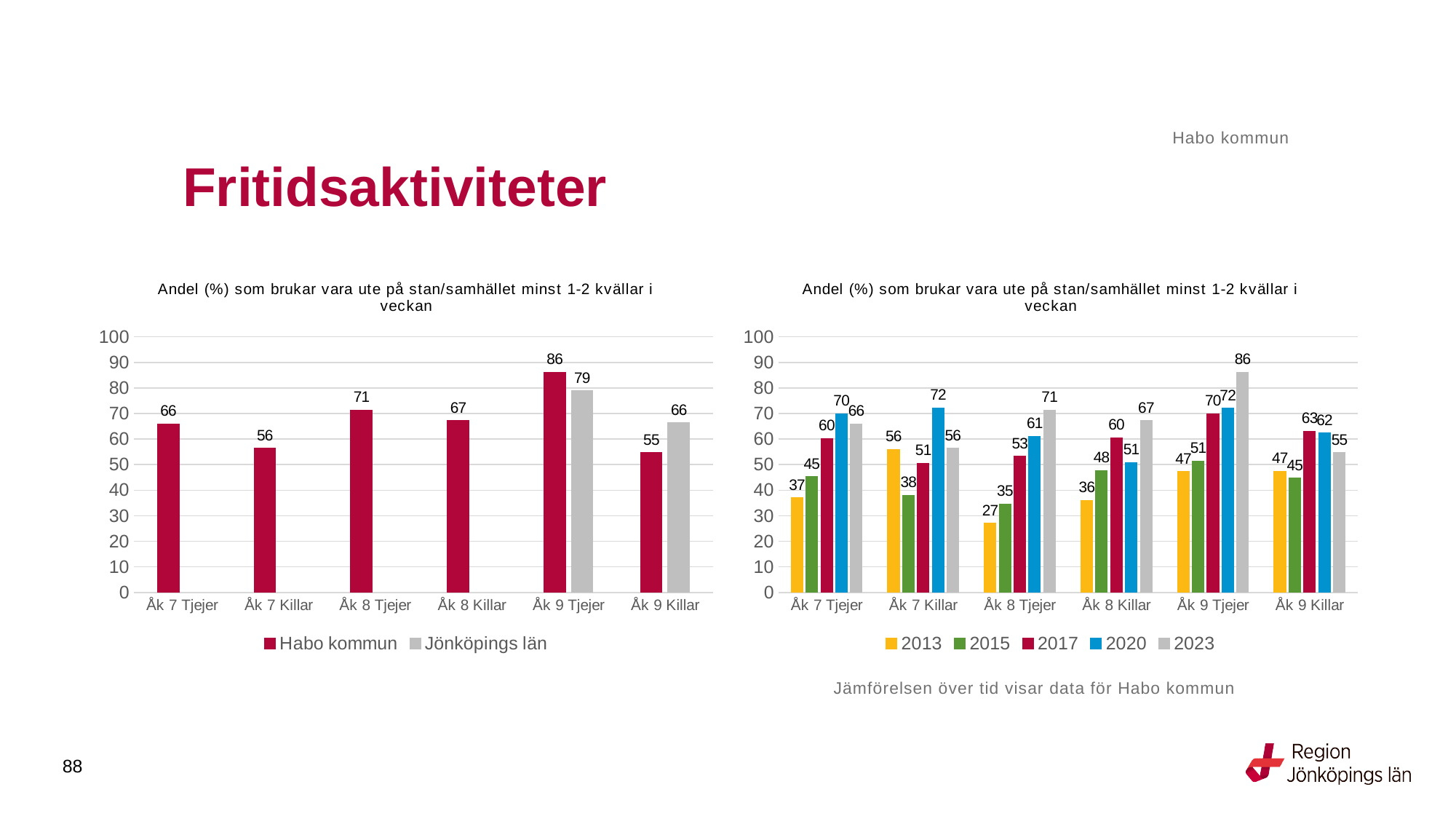
In the left chart, what is the value for Habo kommun for Åk 9 Tjejer? 86 In the right chart, which year has the highest value for Åk 9 Tjejer? 2023 In the left chart, which category has the lowest Habo kommun value? Åk 9 Killar In the right chart, what is the value for 2020 for Åk 7 Killar? 72 In the left chart, what is the value for Jönköpings län for Åk 9 Killar? 66 In the right chart, how many series does the legend list? 5 In the right chart, what is the difference between the 2023 and 2013 values for Åk 8 Tjejer? 44 In the left chart, what is the difference between Habo kommun and Jönköpings län for Åk 9 Tjejer? 7 In the left chart, how many series does the legend list? 2 What kind of chart is the right chart? Bar chart In the right chart, what is the value for 2013 for Åk 8 Tjejer? 27 In the right chart, is the 2017 value for Åk 8 Killar larger than the 2020 value for Åk 8 Killar? Yes